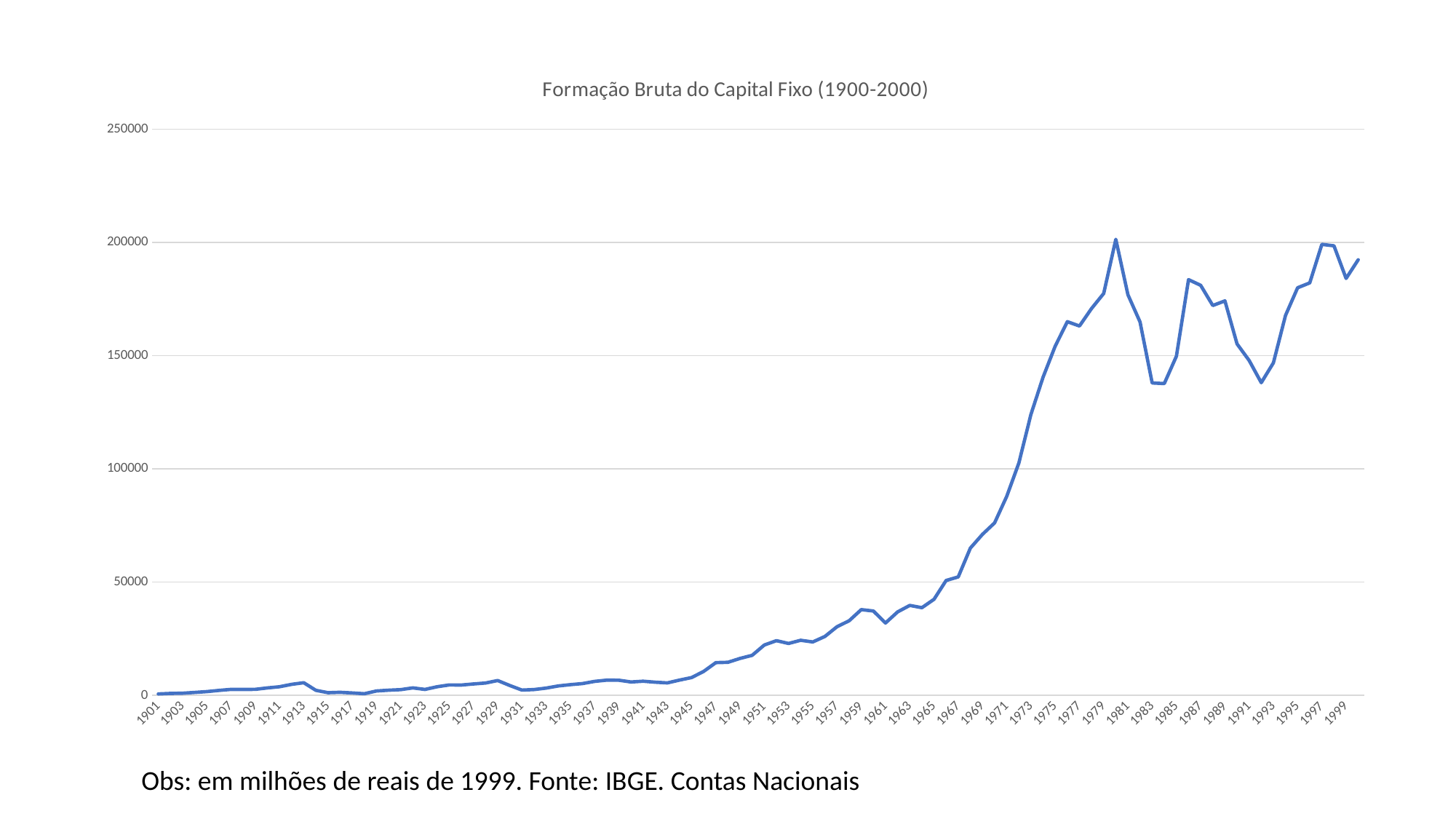
Overall, do the values rise or fall from 1901 to 1999? rise Which year has the larger value, 1983 or 1987? 1987 What is the title of the chart? Formação Bruta do Capital Fixo (1900-2000) Is the value for 1973 greater or less than 100000? greater Between 1993 and 1997, do the values rise or fall? rise Which year has the larger value, 1945 or 1975? 1975 Is the value for 1945 greater or less than 50000? less Between 1981 and 1983, do the values rise or fall? fall Is the value for 1987 greater or less than 150000? greater What is the highest value shown on the vertical axis? 250000 What kind of chart is shown on the slide? line chart